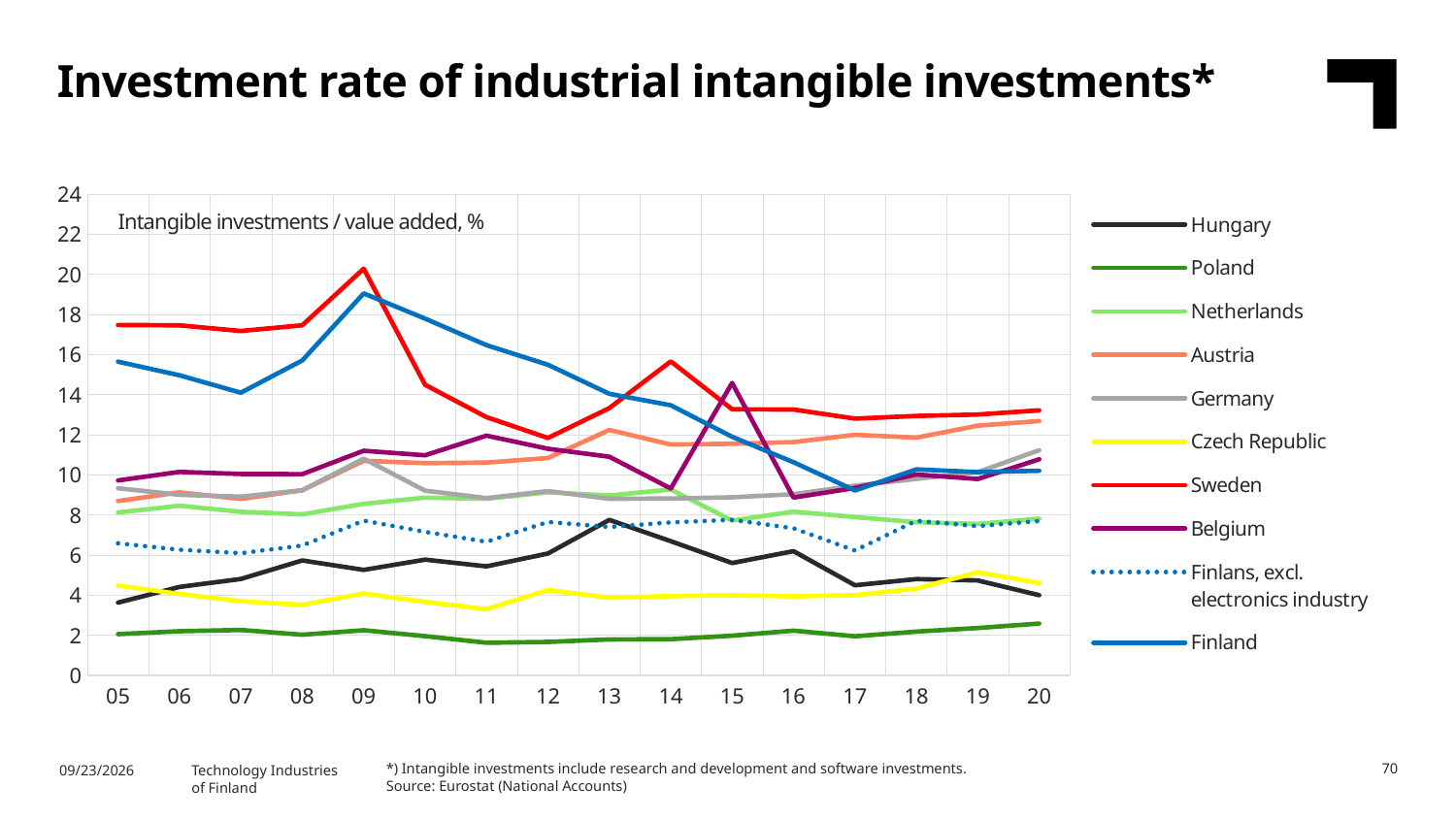
What kind of chart is shown on the slide? line chart Is the value for Finland in 09 greater or less than 18? greater How many years are plotted along the x axis? 16 Does the Finland line rise or fall between 09 and 17? fall Which country has the lowest value in 20? Poland How many series does the legend list? 10 Which country has the highest value in 05? Sweden Which series is drawn as a dotted line? Finlans, excl. electronics industry Is the value for Poland in 20 greater or less than 4? less In which year does the Sweden line reach its peak? 09 Which is larger in 15, the value for Belgium or the value for Germany? Belgium Is the value for Hungary in 13 greater or less than 6? greater